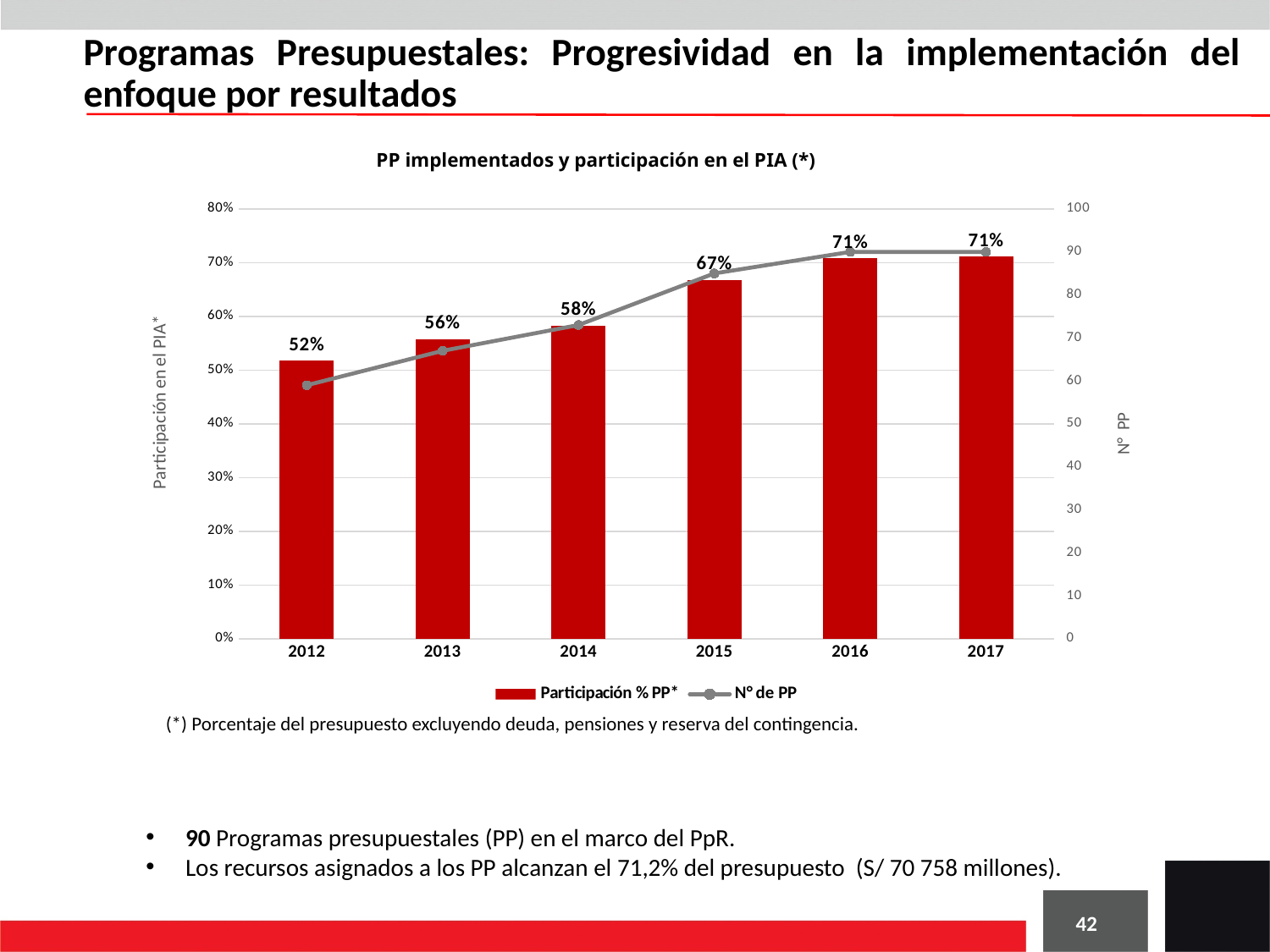
What is the Participación % PP* value for 2015? 67% What is the difference between the Participación % PP* values for 2015 and 2013? 11% What is the Participación % PP* value for 2014? 58% Which year has the lowest Participación % PP* value? 2012 Is the N° de PP value for 2013 greater or less than 60? greater Does the N° de PP line rise or fall from 2012 to 2016? rise What is the title of the chart? PP implementados y participación en el PIA (*) What is the Participación % PP* value for 2012? 52% Which is larger, the Participación % PP* value for 2013 or for 2014? 2014 How many years are shown on the x axis? 6 Is the N° de PP value for 2015 greater or less than 80? greater How many series does the legend list? 2